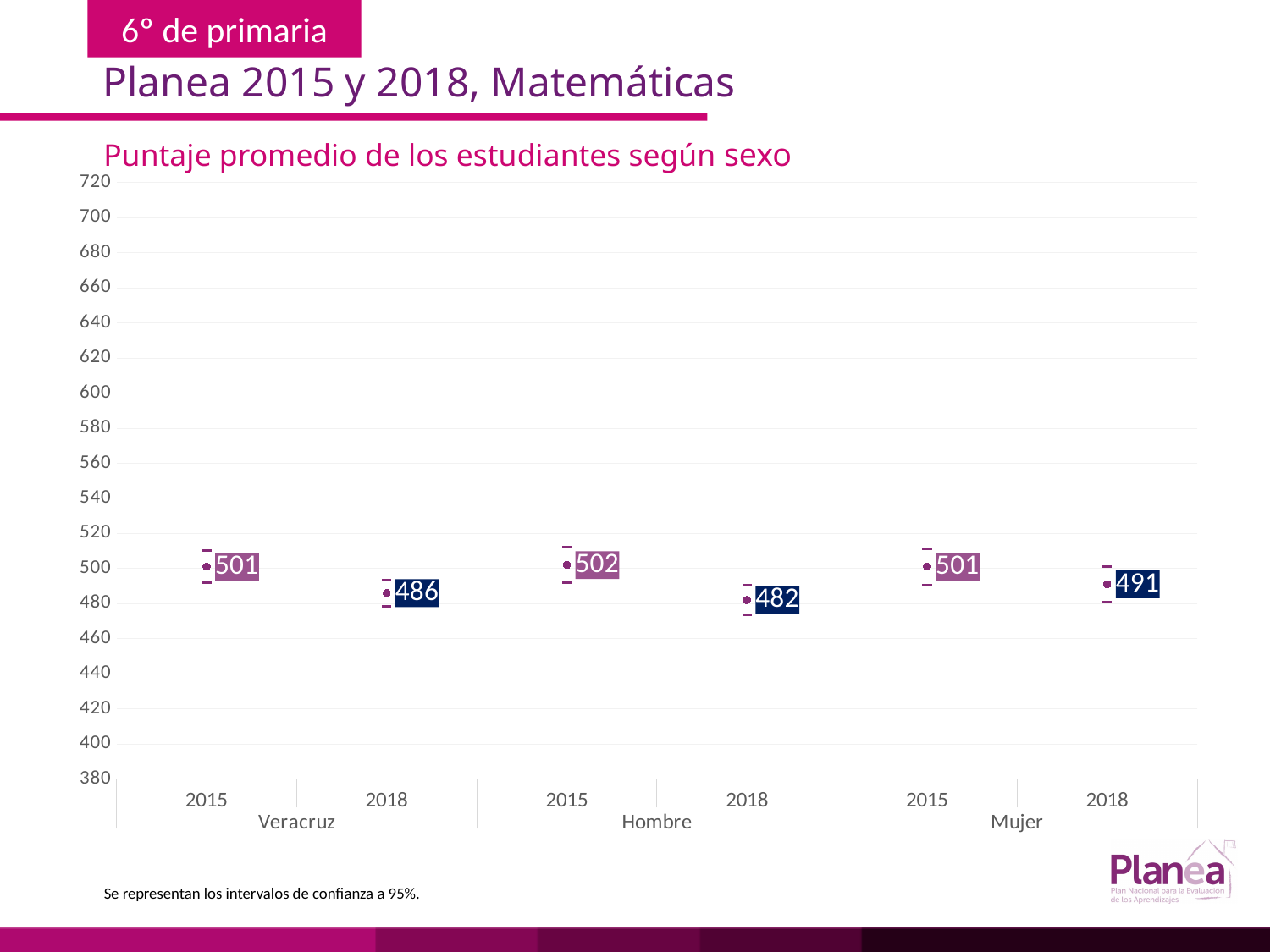
What is the difference between the Mujer scores in 2015 and 2018? 10 Is the 2018 score for Veracruz greater or less than 500? less What is the average score for Hombre in 2018? 482 Which group and year has the highest average score? Hombre 2015 What is the difference between the Hombre scores in 2015 and 2018? 20 Which is larger, the 2018 score for Mujer or the 2018 score for Hombre? Mujer What is the average score for Mujer in 2018? 491 How many data points are plotted on the chart? 6 Which group and year has the lowest average score? Hombre 2018 Do the scores rise or fall from 2015 to 2018 for each group? fall What is the average score for Veracruz in 2018? 486 What is the average score for Veracruz in 2015? 501